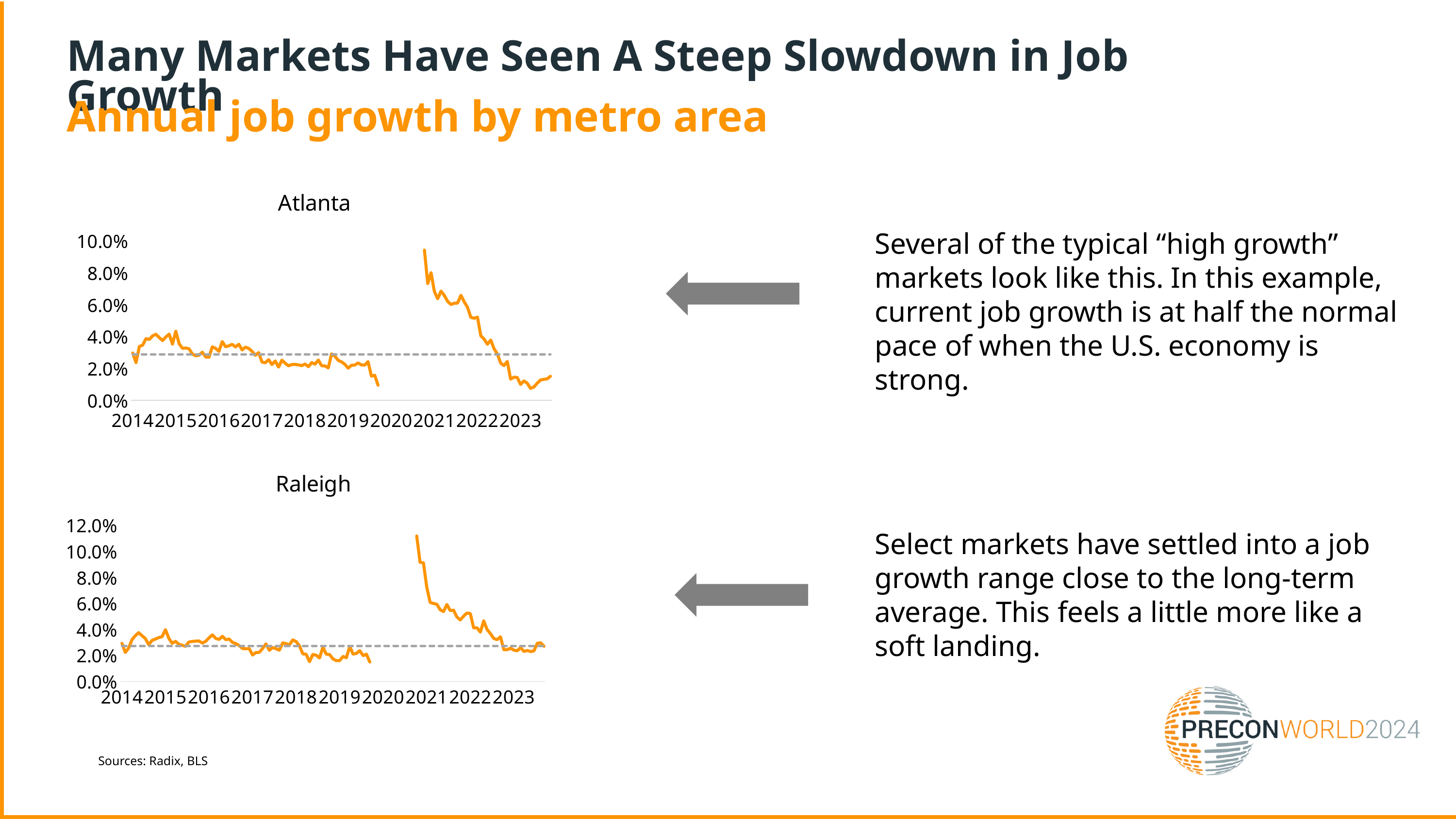
How many charts are shown on the slide? 2 In the Atlanta chart, do the values rise or fall from 2021 to 2023? fall In the Atlanta chart, is the last value before the gap around 2020 greater or less than 2.0%? less In the Raleigh chart, is the peak value in 2021 greater or less than 10.0%? greater In the Atlanta chart, what is the highest value shown on the y axis? 10.0% In the Raleigh chart, is the final value in 2023 greater or less than 2.0%? greater In the Raleigh chart, what is the highest value shown on the y axis? 12.0% What is the title of the bottom chart? Raleigh What is the title of the top chart? Atlanta What kind of chart is the Atlanta chart? line chart How many year labels are shown on the x axis of the Raleigh chart? 10